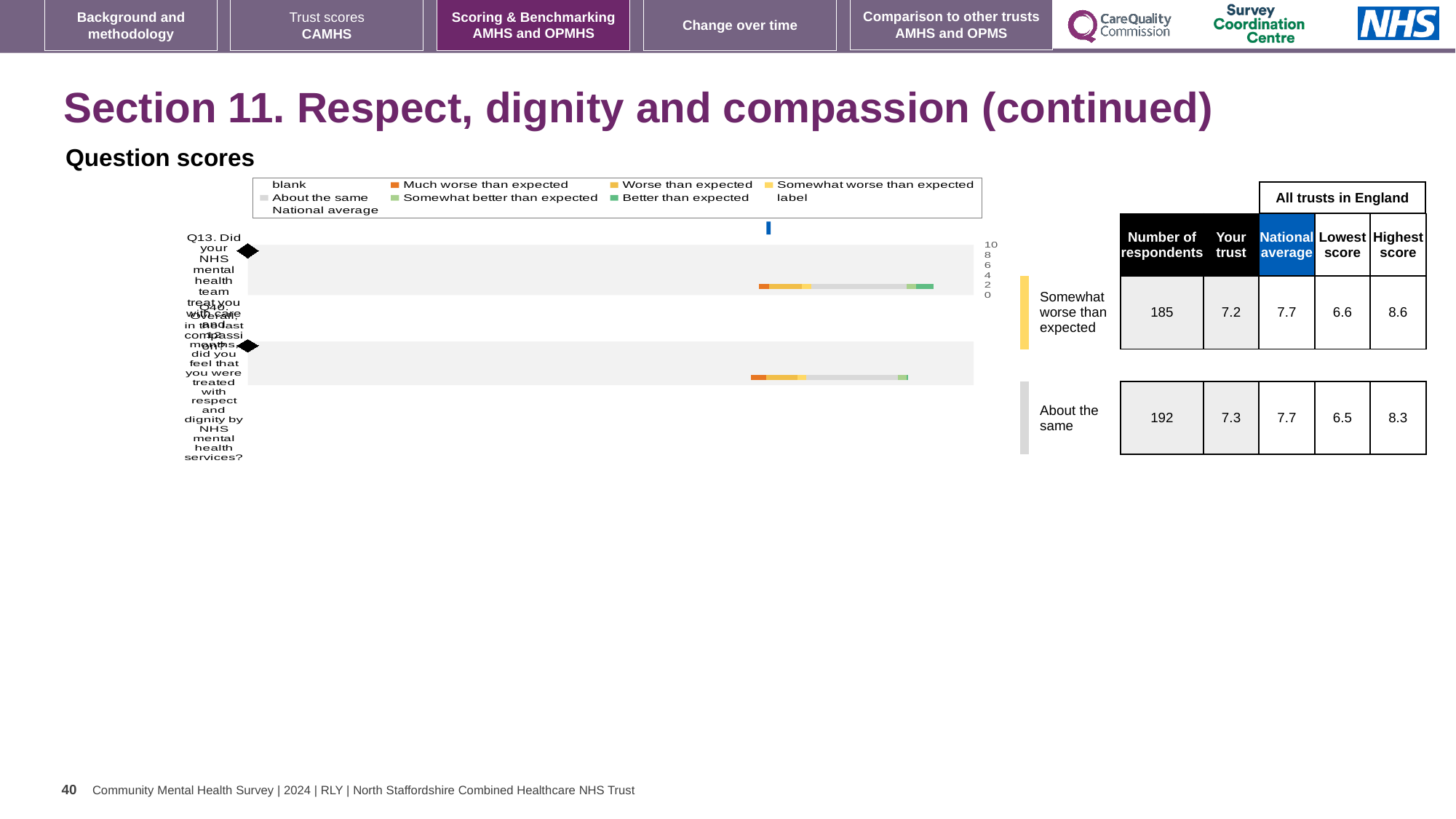
What is the national average score for Q13? 7.7 Which benchmark category is Q13 placed in? Somewhat worse than expected How many respondents answered Q13? 185 Which question had more respondents, Q13 or Q10? Q10 How many respondents answered Q10? 192 What is the lowest score across all trusts in England for Q13? 6.6 What is the difference between the national average and the 'Your trust' score for Q13? 0.5 How many questions are plotted in the 'Question scores' chart? 2 What is the highest score across all trusts in England for Q10? 8.3 What kind of chart is shown under 'Question scores'? bar chart